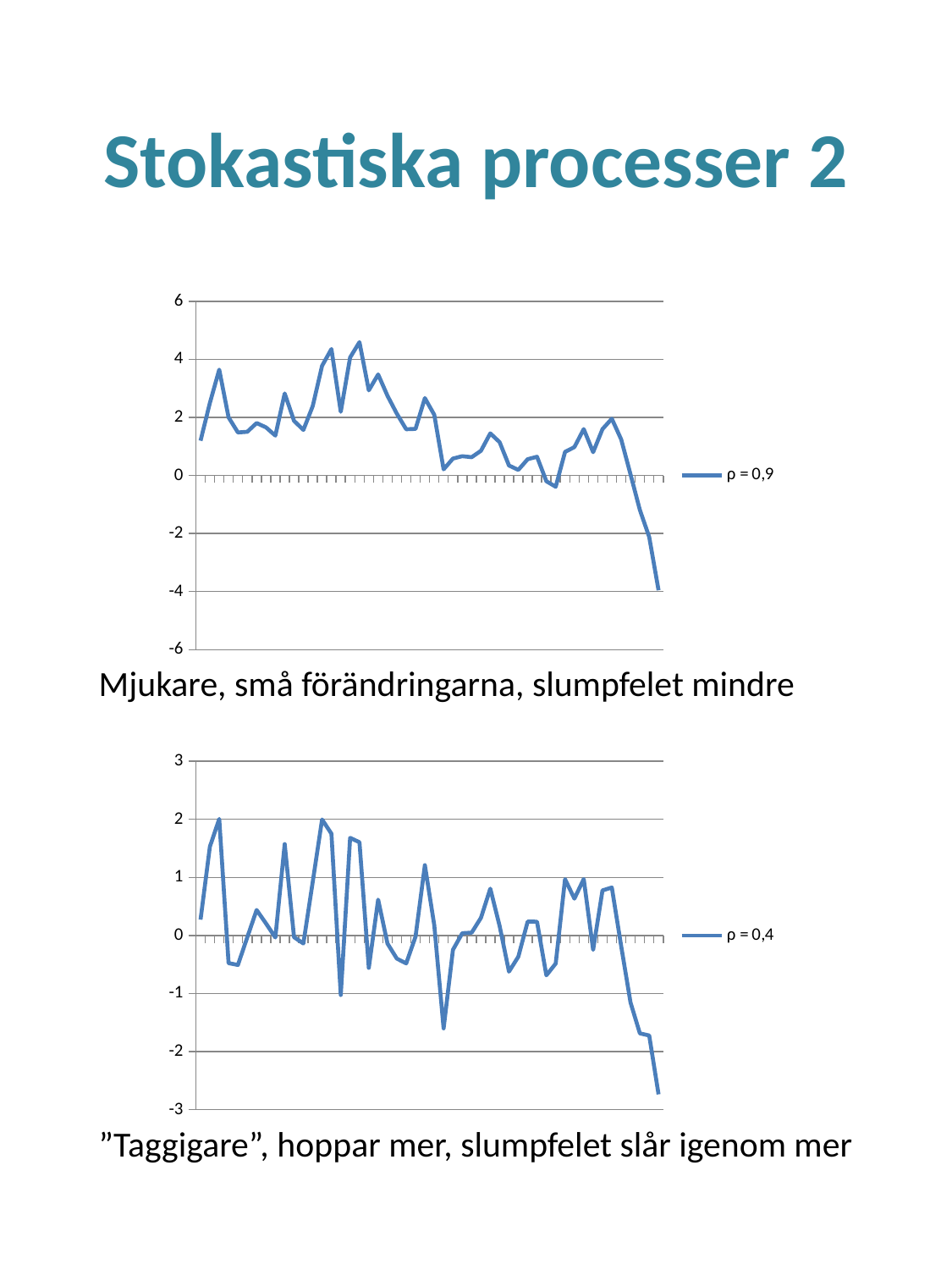
In the bottom chart (ρ = 0,4), is the lowest value of the line greater or less than -3? greater In the top chart (ρ = 0,9), does the line end higher or lower than it starts? lower What kind of chart is the bottom chart on the slide? line chart In the top chart (ρ = 0,9), is the final value of the line greater or less than -2? less What is the legend entry of the top chart? ρ = 0,9 In the bottom chart (ρ = 0,4), does the line end higher or lower than it starts? lower How many series does the legend of the top chart list? 1 In the top chart (ρ = 0,9), is the highest value of the line greater or less than 4? greater How many series does the legend of the bottom chart list? 1 What kind of chart is the top chart on the slide? line chart What is the legend entry of the bottom chart? ρ = 0,4